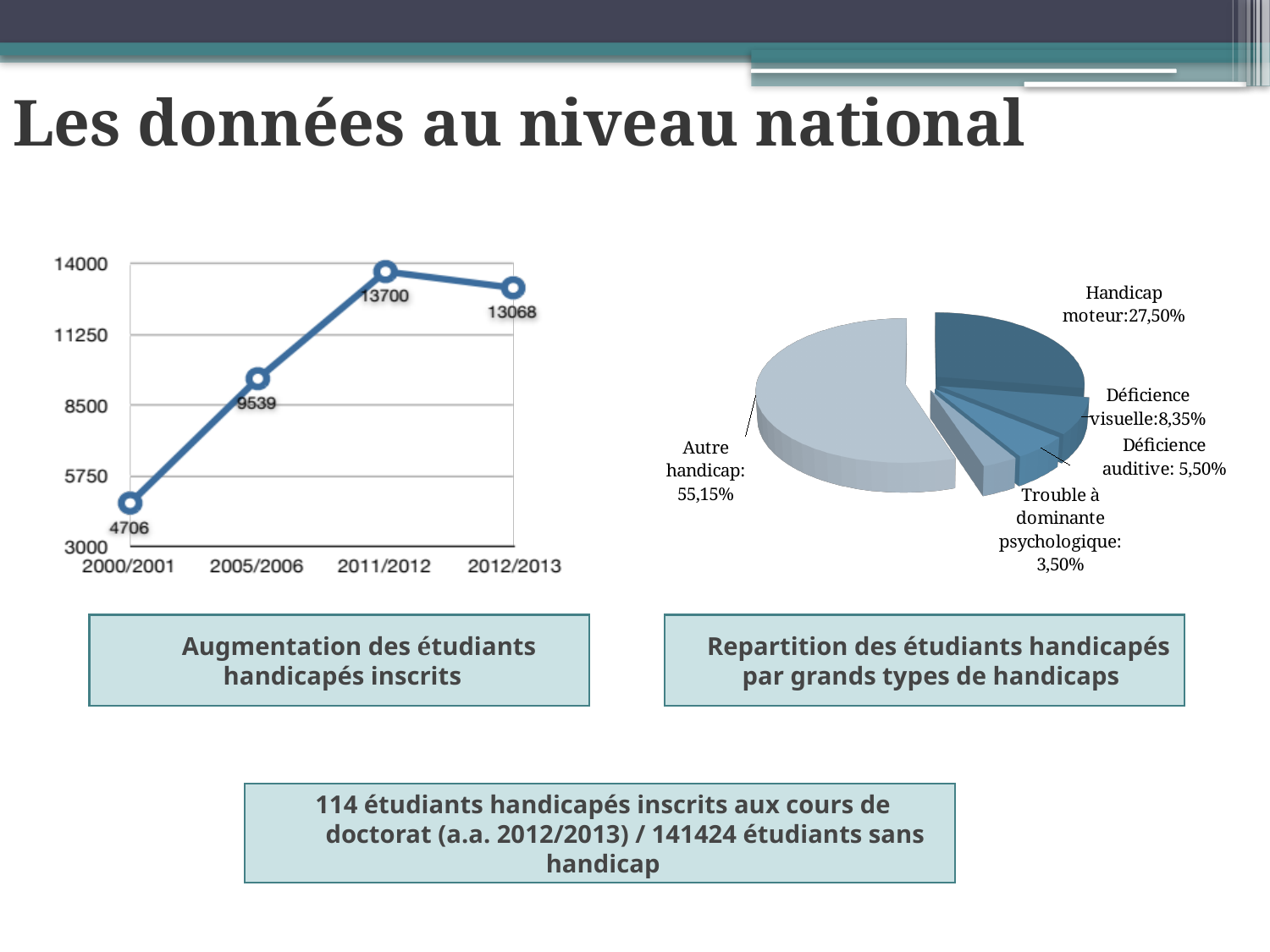
In the left chart (Augmentation des étudiants handicapés inscrits), which year has the lowest value? 2000/2001 In the right chart (Repartition des étudiants handicapés par grands types de handicaps), which category has the smallest slice? Trouble à dominante psychologique In the left chart (Augmentation des étudiants handicapés inscrits), what is the value for 2011/2012? 13700 In the right chart (Repartition des étudiants handicapés par grands types de handicaps), what is the share for Déficience visuelle? 8,35% What kind of chart is the right chart (Repartition des étudiants handicapés par grands types de handicaps)? Pie chart In the left chart (Augmentation des étudiants handicapés inscrits), how many data points are plotted? 4 In the left chart (Augmentation des étudiants handicapés inscrits), what is the value for 2000/2001? 4706 In the left chart (Augmentation des étudiants handicapés inscrits), what is the difference between the values for 2005/2006 and 2000/2001? 4833 In the left chart (Augmentation des étudiants handicapés inscrits), which year has the highest value? 2011/2012 In the left chart (Augmentation des étudiants handicapés inscrits), does the value rise or fall from 2011/2012 to 2012/2013? Fall In the right chart (Repartition des étudiants handicapés par grands types de handicaps), which category has the largest slice? Autre handicap What kind of chart is the left chart (Augmentation des étudiants handicapés inscrits)? Line chart